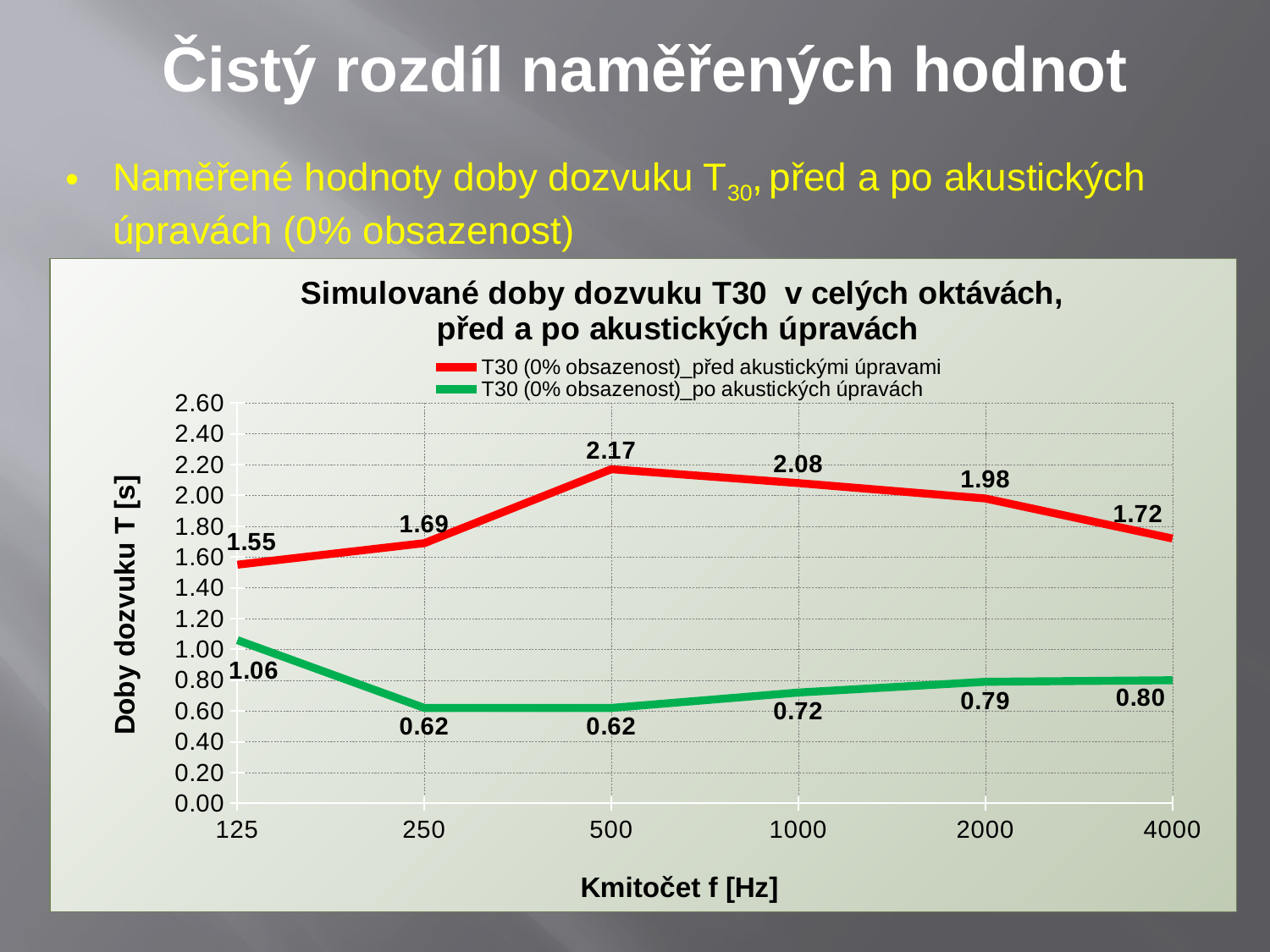
At which frequency does the 'T30 (0% obsazenost)_po akustických úpravách' series reach its highest value? 125 How many series does the legend list? 2 What is the difference between the two series at 2000 Hz? 1.19 What is the value of the 'T30 (0% obsazenost)_před akustickými úpravami' series at 500 Hz? 2.17 What is the difference between the two series at 500 Hz? 1.55 What is the value of the 'T30 (0% obsazenost)_po akustických úpravách' series at 125 Hz? 1.06 What kind of chart is shown on the slide? line chart Which series has the larger value at 1000 Hz? T30 (0% obsazenost)_před akustickými úpravami What is the value of the 'T30 (0% obsazenost)_před akustickými úpravami' series at 4000 Hz? 1.72 At which frequency does the 'T30 (0% obsazenost)_před akustickými úpravami' series reach its highest value? 500 How many frequency points are plotted on the x axis? 6 At which frequency does the 'T30 (0% obsazenost)_před akustickými úpravami' series have its lowest value? 125